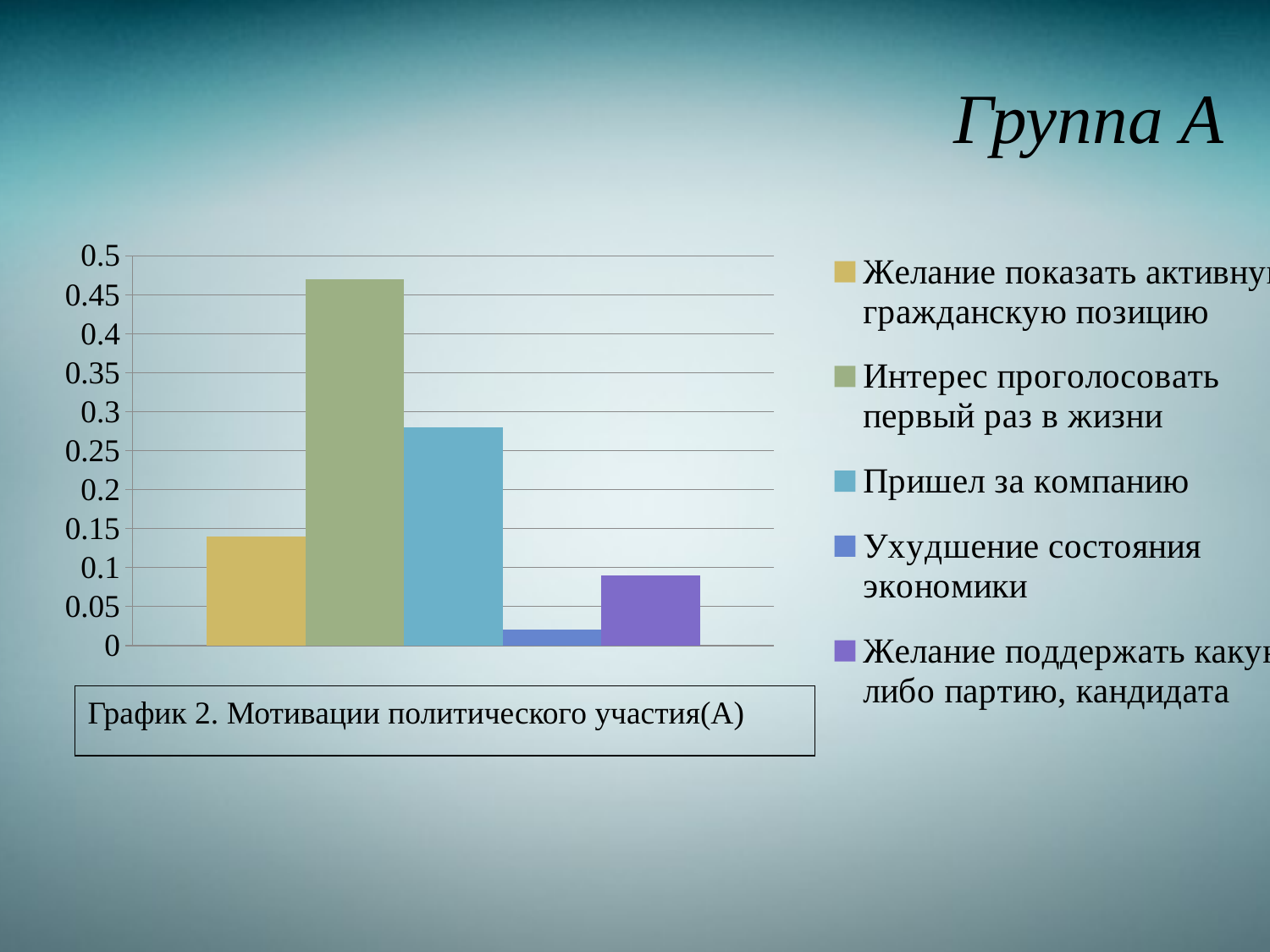
Is the value for "Ухудшение состояния экономики" greater or less than 0.05? less What colour is the bar for "Пришел за компанию"? light blue Which is larger: the value for "Пришел за компанию" or the value for "Ухудшение состояния экономики"? Пришел за компанию How many series does the legend list? 5 Is the value for "Пришел за компанию" greater or less than 0.3? less Is the value for "Пришел за компанию" greater or less than 0.25? greater What is the caption printed below the chart? График 2. Мотивации политического участия(А) What kind of chart is shown on the slide? bar chart How many bars are plotted in the chart? 5 Which series has the highest value? Интерес проголосовать первый раз в жизни Which series has the lowest value? Ухудшение состояния экономики